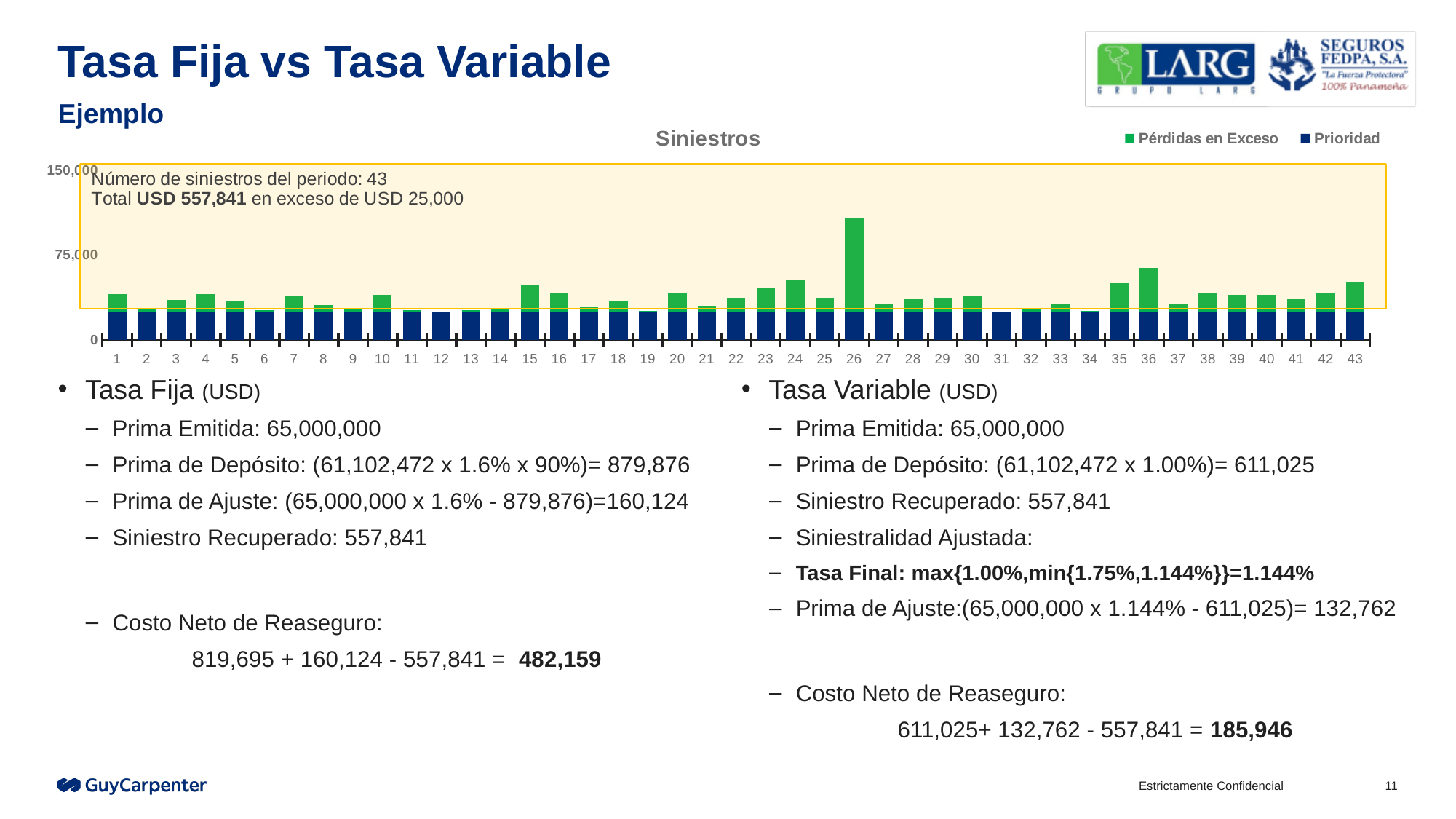
In the 'Siniestros' chart, which bar is taller: category 26 or category 36? 26 Which series in the 'Siniestros' chart is shown in green? Pérdidas en Exceso Which category has the tallest bar in the 'Siniestros' chart? 26 In the 'Siniestros' chart, which bar is taller: category 36 or category 24? 36 In the 'Siniestros' chart, is the total bar for category 36 greater or less than 75,000? less What kind of chart is the 'Siniestros' chart? bar chart What is the title of the chart on the slide? Siniestros In the 'Siniestros' chart, is the total bar for category 26 greater or less than 75,000? greater How many series does the legend of the 'Siniestros' chart list? 2 In the 'Siniestros' chart, is the total bar for category 1 greater or less than 75,000? less How many categories are shown on the x axis of the 'Siniestros' chart? 43